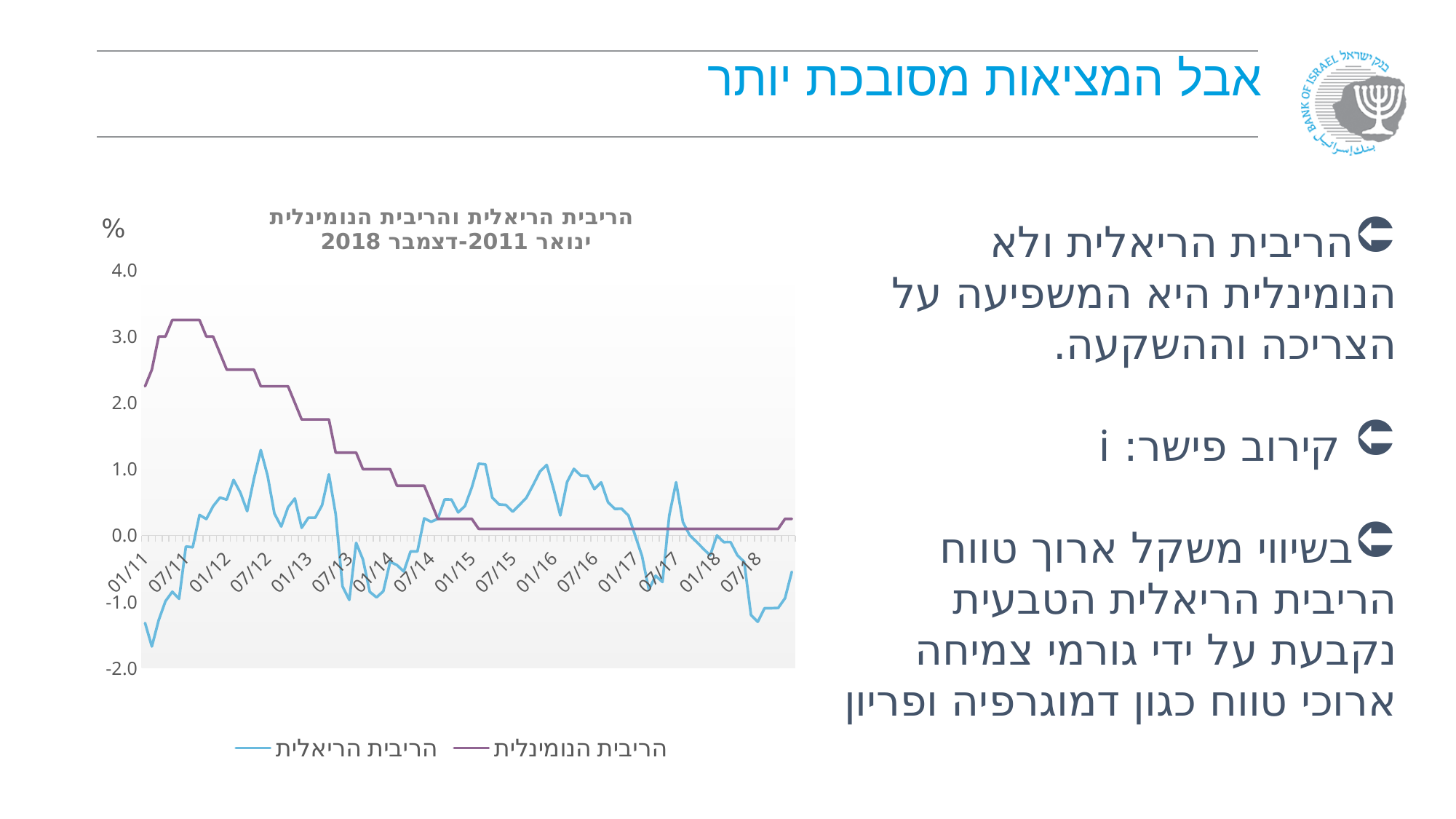
What unit is shown on the chart's vertical axis? % How many series does the chart's legend list? 2 Which series reaches the highest value anywhere on the chart? הריבית הנומינלית Is the value of הריבית הריאלית at 01/11 greater or less than -1.0? less How many date labels are shown on the chart's x axis? 16 What kind of chart is shown on the slide? line chart At 01/12, which series has the larger value, הריבית הריאלית or הריבית הנומינלית? הריבית הנומינלית Is the value of הריבית הנומינלית at 01/13 greater or less than 1.0? greater Does the nominal interest rate (הריבית הנומינלית) line rise or fall overall from 01/11 to 01/15? fall Is the value of הריבית הנומינלית at 01/16 greater or less than 1.0? less What is the title of the chart? הריבית הריאלית והריבית הנומינלית ינואר 2011-דצמבר 2018